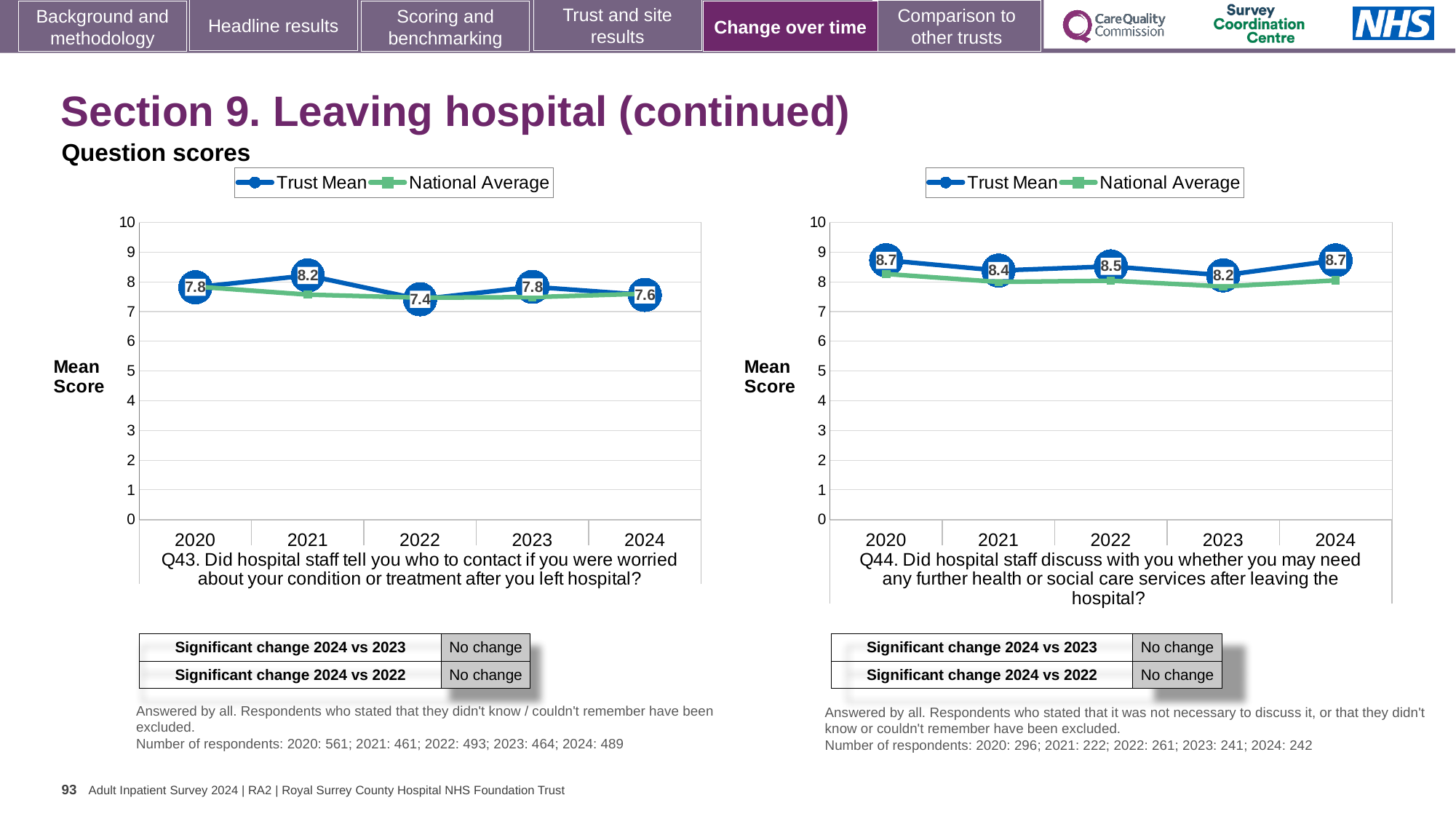
In the Q43 chart (left), what is the Trust Mean score for 2024? 7.6 In the Q44 chart (right), what is the Trust Mean score for 2023? 8.2 How many series does the legend of the Q43 chart (left) list? 2 In the Q43 chart (left), which year has the highest Trust Mean score? 2021 How many years are plotted on the x axis of the Q44 chart (right)? 5 In the Q43 chart (left), what is the Trust Mean score for 2021? 8.2 In the Q44 chart (right), which year has the lowest Trust Mean score? 2023 In the Q43 chart (left), what is the difference between the Trust Mean scores for 2021 and 2022? 0.8 In the Q44 chart (right), is the Trust Mean score for 2020 higher or lower than for 2021? higher In the Q44 chart (right), what does the table say about the significant change 2024 vs 2023? No change What type of chart is used for Q44 (right)? line chart In the Q43 chart (left), is the National Average for 2024 greater or less than 5? greater